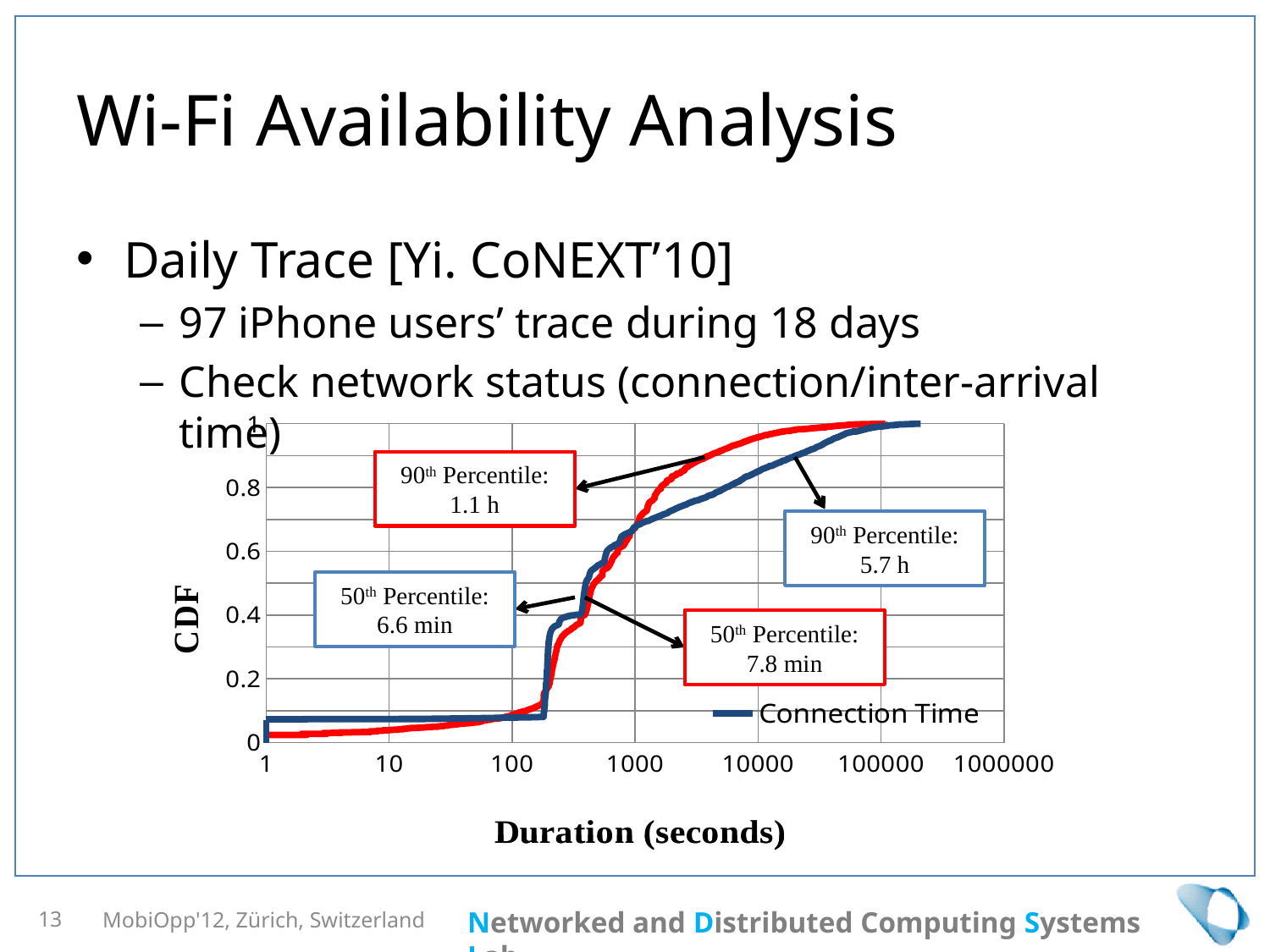
What is the 90th percentile value given in the red annotation box pointing to the red curve? 1.1 h What is the label of the x axis of the chart? Duration (seconds) What kind of chart is shown on the slide? line chart What is the 50th percentile value given in the annotation pointing to the Connection Time curve? 6.6 min What is the 90th percentile value given in the annotation pointing to the Connection Time curve? 5.7 h How many tick labels are shown on the x axis of the chart? 7 Is the CDF value of the Connection Time curve at a duration of 100000 seconds greater or less than 0.8? greater Is the CDF value of the red curve at a duration of 1000 seconds greater or less than 0.6? greater Do the CDF curves rise or fall as Duration increases along the x axis? rise What is the label of the y axis of the chart? CDF What is the 50th percentile value given in the red annotation box pointing to the red curve? 7.8 min Is the CDF value of the Connection Time curve at a duration of 100 seconds greater or less than 0.2? less